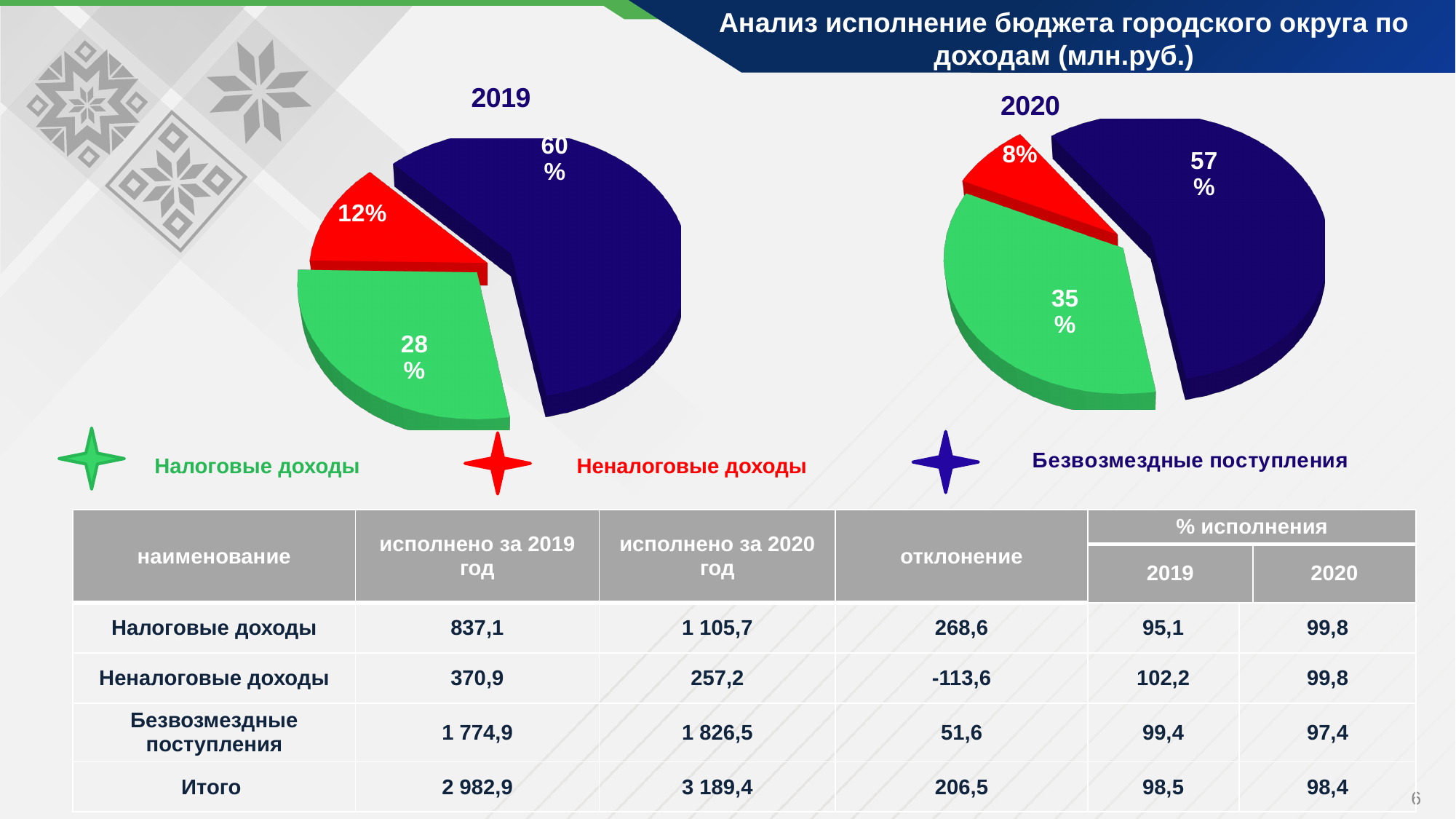
In the 2019 pie chart, what share is shown for Налоговые доходы? 28% In the 2020 pie chart, which category has the largest slice? Безвозмездные поступления By how many percentage points does the share of Налоговые доходы in the 2020 pie chart exceed its share in the 2019 pie chart? 7 In the 2020 pie chart, what share is shown for Безвозмездные поступления? 57% What kind of chart is used for the 2019 data on the slide? Pie chart How many slices does each pie chart on the slide have? 3 In the 2020 pie chart, what share is shown for Неналоговые доходы? 8% In the 2019 pie chart, which category has the smallest slice? Неналоговые доходы Which colour represents Неналоговые доходы in the pie charts? Red